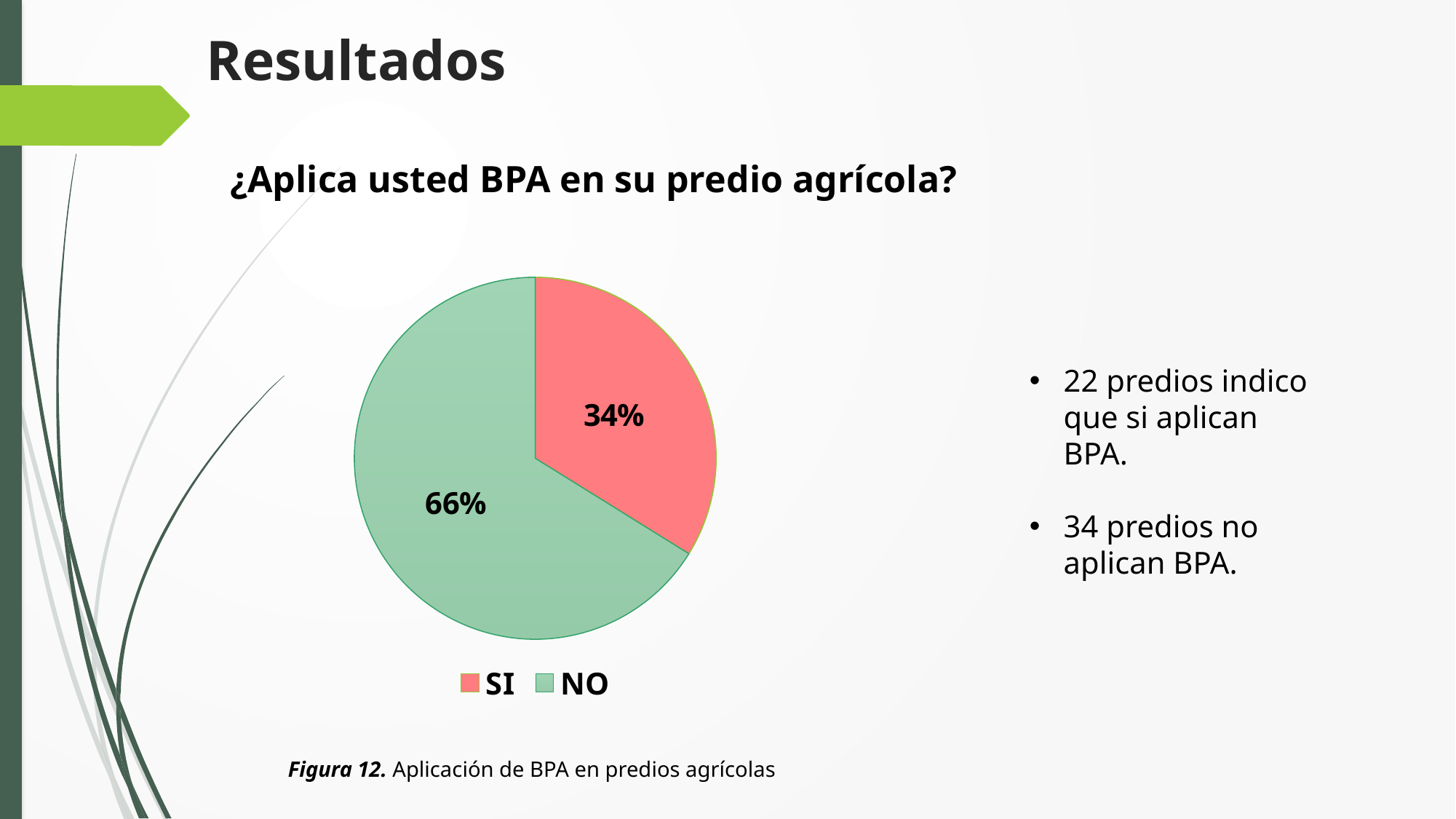
Which slice of the pie is the smallest? SI What share of the pie does the SI slice represent? 34% What colour is the NO slice in the pie chart? green What kind of chart is shown on the slide? pie chart What is the title of the chart? ¿Aplica usted BPA en su predio agrícola? How many entries does the legend list? 2 How many slices does the pie chart have? 2 What percentage of the pie is labelled NO? 66% What is the difference in percentage points between the NO slice and the SI slice? 32 Which slice of the pie is the largest? NO Which is larger, the SI slice or the NO slice? NO What percentage of the pie is labelled SI? 34%